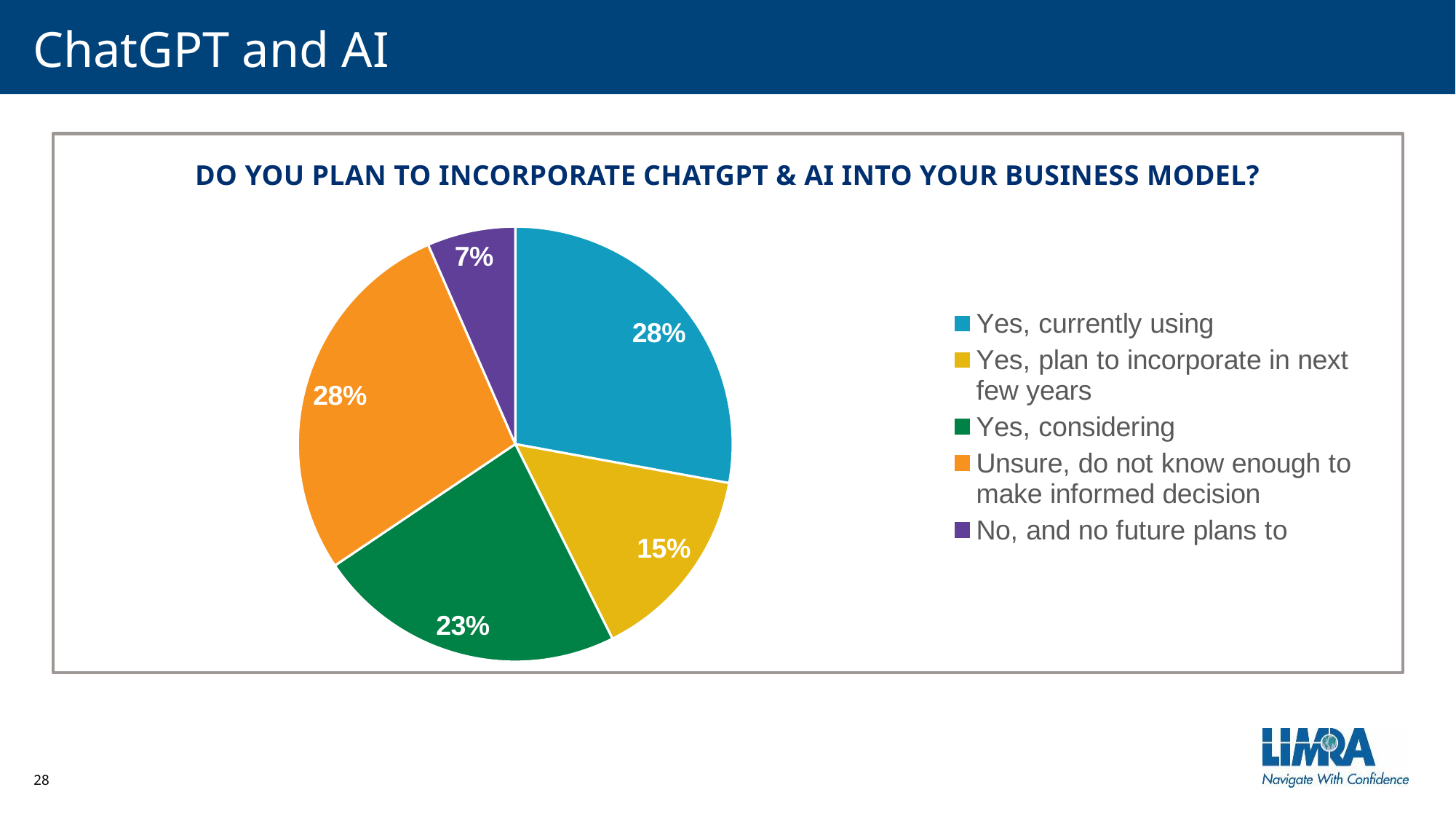
What share of respondents answered "Unsure, do not know enough to make informed decision"? 28% How many slices does the pie chart have? 5 What kind of chart is shown on the slide? Pie chart What is the title of the pie chart? DO YOU PLAN TO INCORPORATE CHATGPT & AI INTO YOUR BUSINESS MODEL? What colour is the slice for "Unsure, do not know enough to make informed decision"? Orange What share of respondents answered "No, and no future plans to"? 7% What share of respondents answered "Yes, currently using"? 28% Which is larger: the share for "Yes, considering" or the share for "No, and no future plans to"? Yes, considering What is the difference in percentage points between "Yes, considering" and "Yes, plan to incorporate in next few years"? 8 percentage points What share of respondents answered "Yes, plan to incorporate in next few years"? 15% Which response has the smallest slice of the pie? No, and no future plans to What share of respondents answered "Yes, considering"? 23%